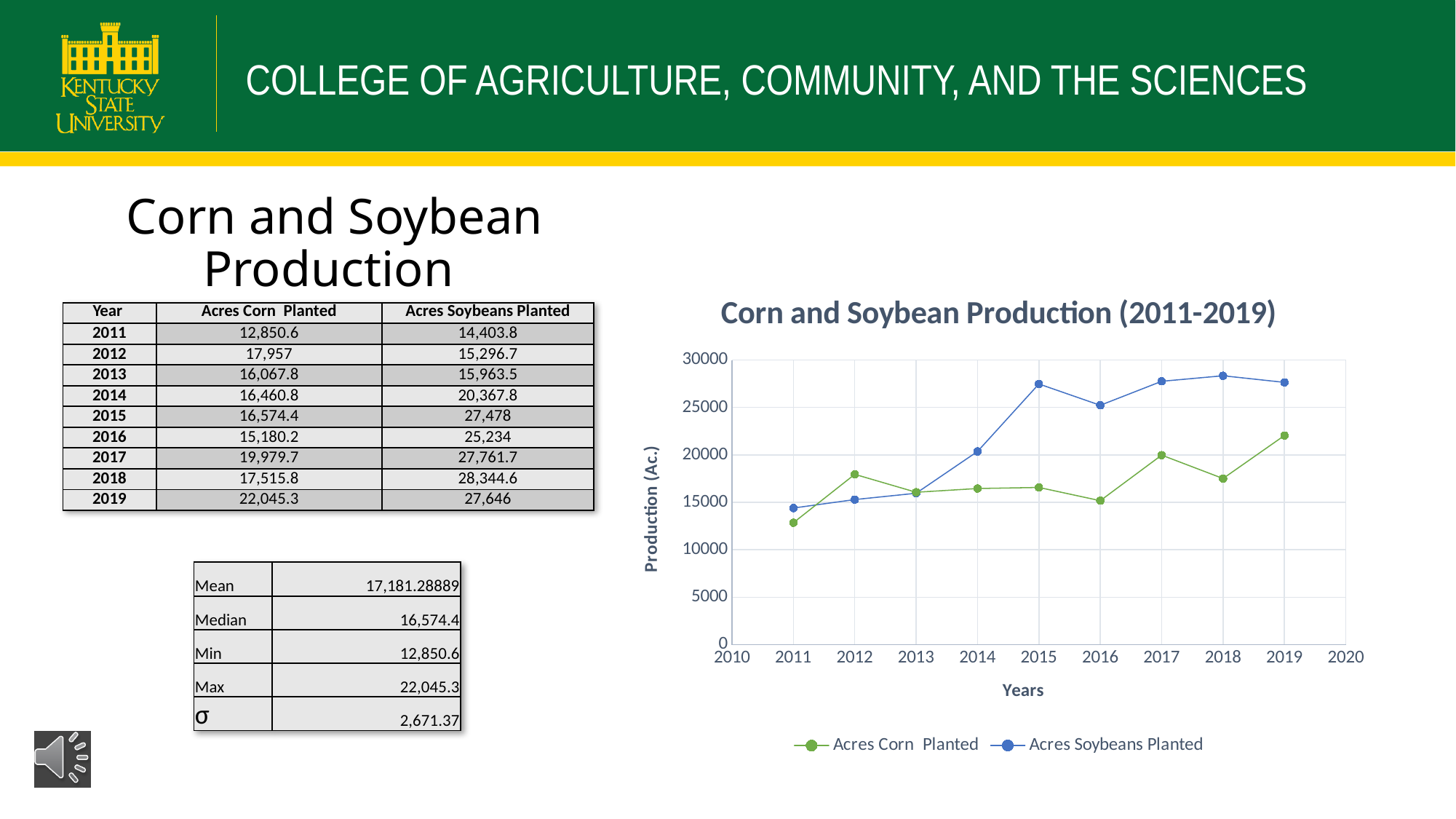
What is the value of Acres Soybeans Planted in 2018? 28,344.6 How many series does the chart legend list? 2 What is the title of the chart? Corn and Soybean Production (2011-2019) Does Acres Soybeans Planted rise or fall from 2011 to 2015? rise How many years are plotted for each series in the chart? 9 In which year is Acres Soybeans Planted highest? 2018 What is the value of Acres Corn Planted in 2019? 22,045.3 Which series has the larger value in 2012, Acres Corn Planted or Acres Soybeans Planted? Acres Corn Planted In which year is Acres Corn Planted lowest? 2011 Is the value for Acres Soybeans Planted in 2017 greater or less than 25000? greater What is the difference between Acres Soybeans Planted and Acres Corn Planted in 2015? 10,903.6 What type of chart is shown on the slide? line chart